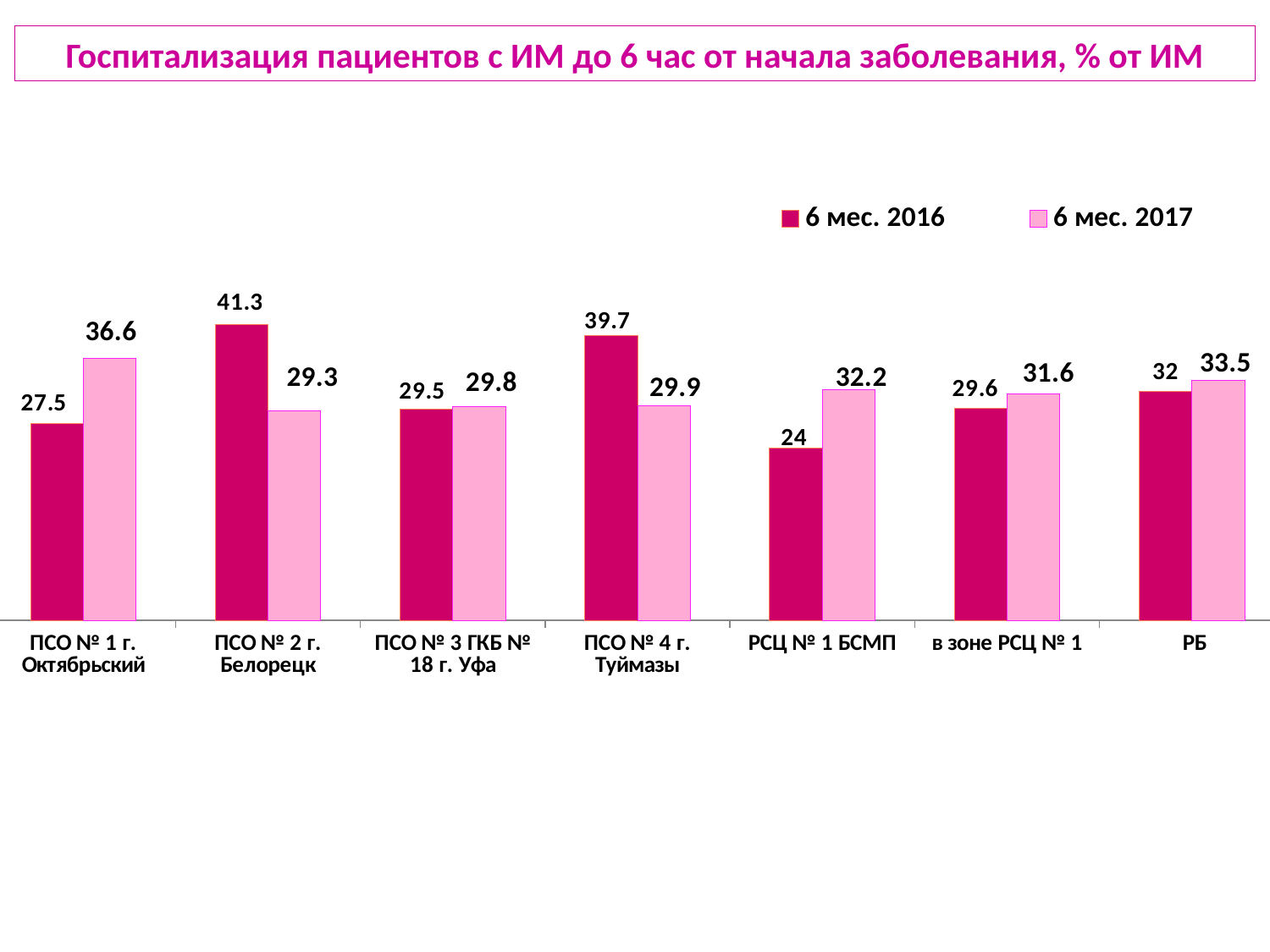
Which category has the highest value in the 6 мес. 2016 series? ПСО № 2 г. Белорецк How many series does the legend list? 2 How many categories are shown on the x axis? 7 What is the value for РБ in the 6 мес. 2017 series? 33.5 What is the value for ПСО № 2 г. Белорецк in the 6 мес. 2016 series? 41.3 Which category has the highest value in the 6 мес. 2017 series? ПСО № 1 г. Октябрьский What is the difference between the 6 мес. 2016 and 6 мес. 2017 values for ПСО № 4 г. Туймазы? 9.8 What is the value for РСЦ № 1 БСМП in the 6 мес. 2016 series? 24 For РСЦ № 1 БСМП, which series has the larger value: 6 мес. 2016 or 6 мес. 2017? 6 мес. 2017 What is the value for ПСО № 1 г. Октябрьский in the 6 мес. 2017 series? 36.6 Which category has the lowest value in the 6 мес. 2016 series? РСЦ № 1 БСМП What kind of chart is shown on the slide? Bar chart